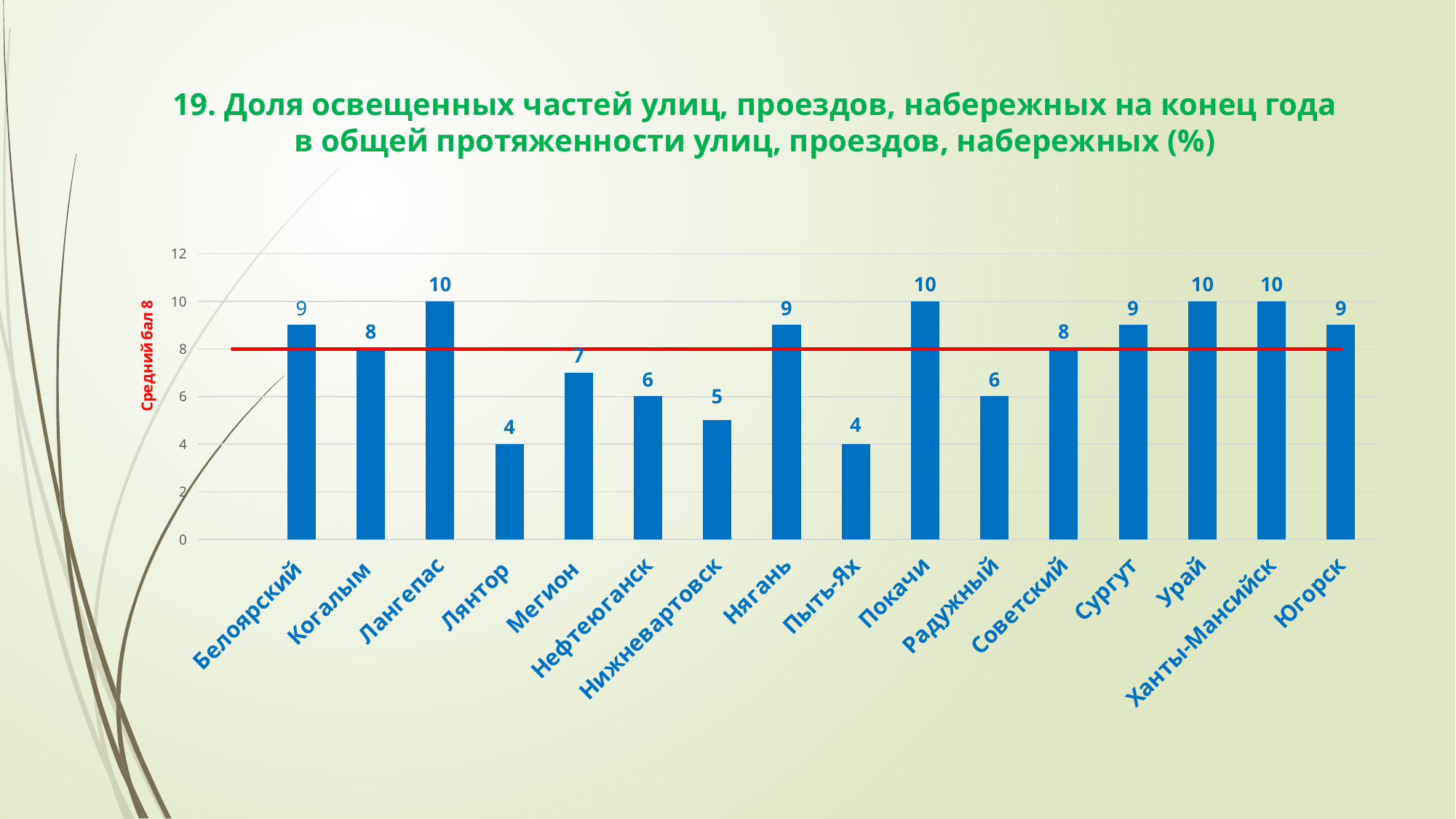
Is the value for Пыть-Ях greater or less than 6? less What is the difference between the values for Лангепас and Лянтор? 6 How many categories are shown on the x axis? 16 What value does the red horizontal line mark, according to its label? 8 What is the lowest value shown on the chart? 4 What is the value for Ханты-Мансийск? 10 What is the highest value shown on the chart? 10 What is the value for Советский? 8 What kind of chart is shown on the slide? combination bar and line chart Which has a larger value, Нягань or Радужный? Нягань What is the value for Мегион? 7 What is the value for Нижневартовск? 5